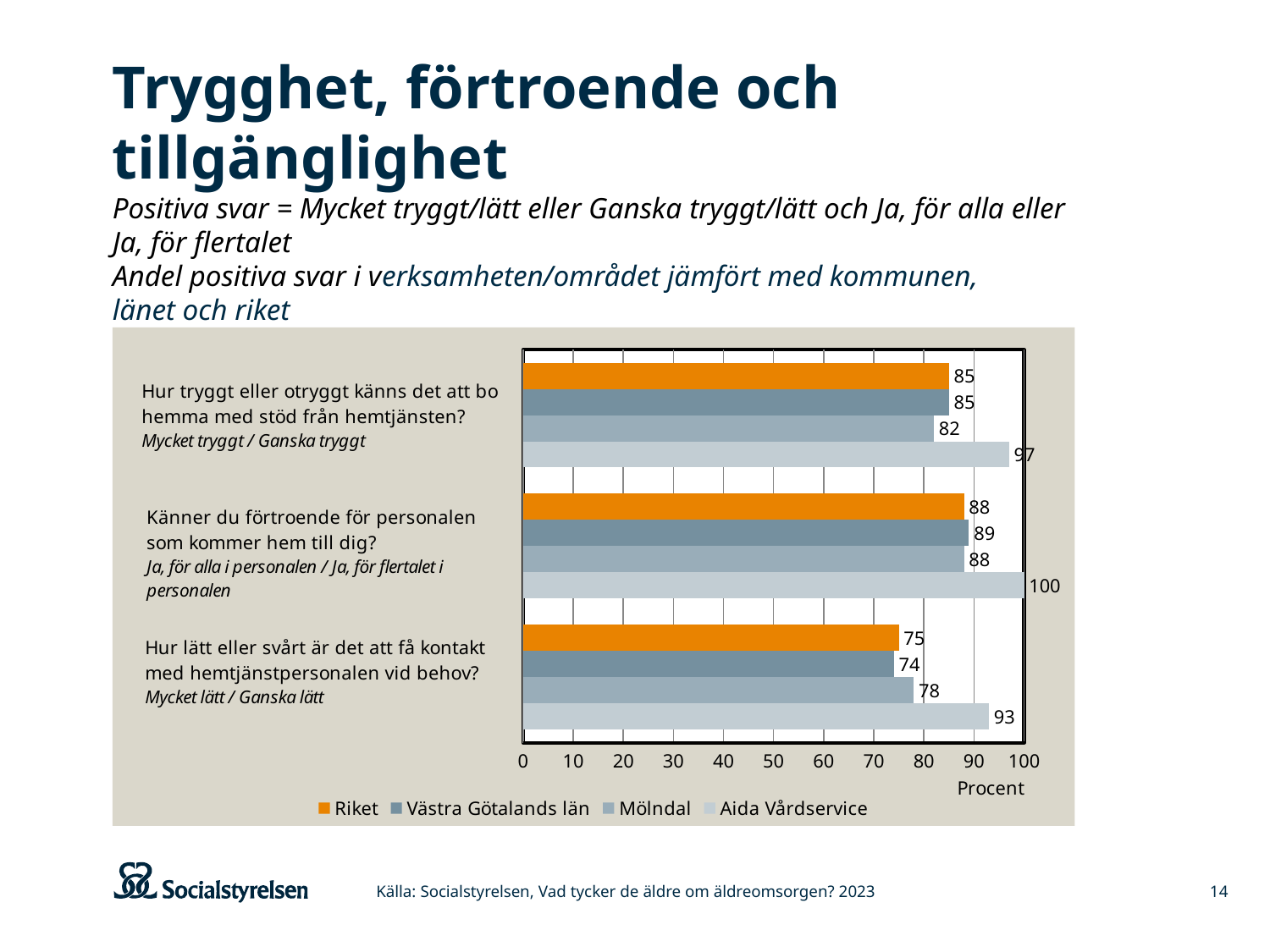
What is the difference between Aida Vårdservice and Riket on the question "Hur lätt eller svårt är det att få kontakt med hemtjänstpersonalen vid behov?"? 18 What is the value for Riket on the question "Hur lätt eller svårt är det att få kontakt med hemtjänstpersonalen vid behov?"? 75 Which is larger on the question "Känner du förtroende för personalen som kommer hem till dig?": Aida Vårdservice or Mölndal? Aida Vårdservice How many series does the legend list? 4 What kind of chart is shown on the slide? bar chart What unit is shown on the x axis of the chart? Procent What is the value for Aida Vårdservice on the question "Känner du förtroende för personalen som kommer hem till dig?"? 100 Which series has the lowest value on the question "Hur tryggt eller otryggt känns det att bo hemma med stöd från hemtjänsten?"? Mölndal What is the value for Mölndal on the question "Hur tryggt eller otryggt känns det att bo hemma med stöd från hemtjänsten?"? 82 Is the value for Västra Götalands län on the question "Hur lätt eller svårt är det att få kontakt med hemtjänstpersonalen vid behov?" greater or less than 80? less Which series has the highest value on the question "Hur lätt eller svårt är det att få kontakt med hemtjänstpersonalen vid behov?"? Aida Vårdservice How many question categories are plotted on the chart? 3